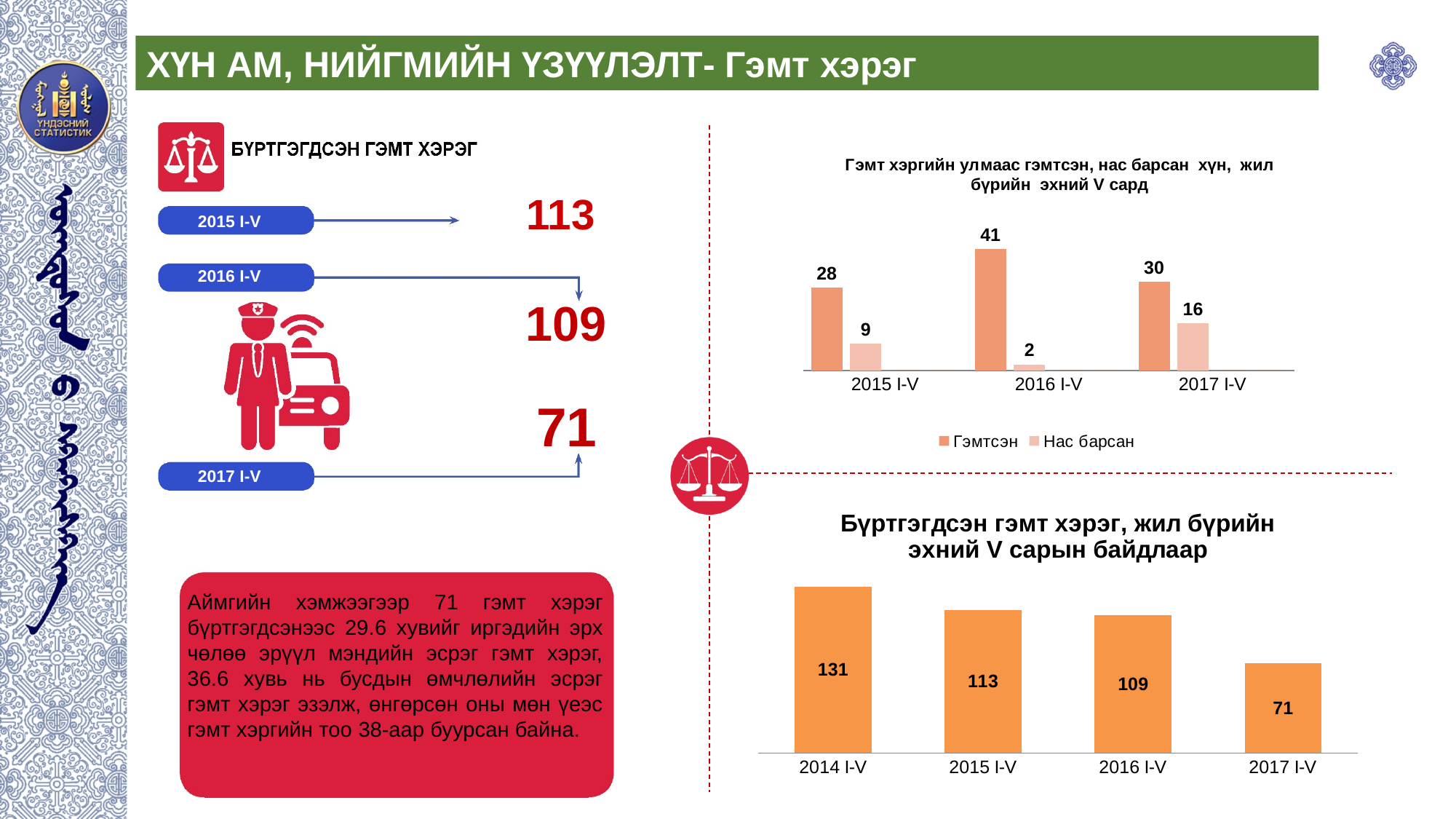
In the top-right chart (Гэмт хэргийн улмаас гэмтсэн, нас барсан хүн), what is the value for Нас барсан in 2017 I-V? 16 What kind of chart is the bottom-right chart (Бүртгэгдсэн гэмт хэрэг)? bar chart In the bottom-right chart (Бүртгэгдсэн гэмт хэрэг), do the values rise or fall from 2014 I-V to 2017 I-V? fall How many series does the legend of the top-right chart (Гэмт хэргийн улмаас гэмтсэн, нас барсан хүн) list? 2 How many categories are shown on the x axis of the bottom-right chart (Бүртгэгдсэн гэмт хэрэг)? 4 In the bottom-right chart (Бүртгэгдсэн гэмт хэрэг), which year has the lowest value? 2017 I-V In the top-right chart (Гэмт хэргийн улмаас гэмтсэн, нас барсан хүн), what is the difference between Гэмтсэн and Нас барсан in 2015 I-V? 19 In the top-right chart (Гэмт хэргийн улмаас гэмтсэн, нас барсан хүн), which year has the highest Гэмтсэн value? 2016 I-V In the bottom-right chart (Бүртгэгдсэн гэмт хэрэг), what is the value for 2014 I-V? 131 In the top-right chart (Гэмт хэргийн улмаас гэмтсэн, нас барсан хүн), what is the value for Гэмтсэн in 2016 I-V? 41 In the bottom-right chart (Бүртгэгдсэн гэмт хэрэг), what is the difference between the 2016 I-V and 2017 I-V values? 38 In the top-right chart (Гэмт хэргийн улмаас гэмтсэн, нас барсан хүн), which year has the lowest Нас барсан value? 2016 I-V